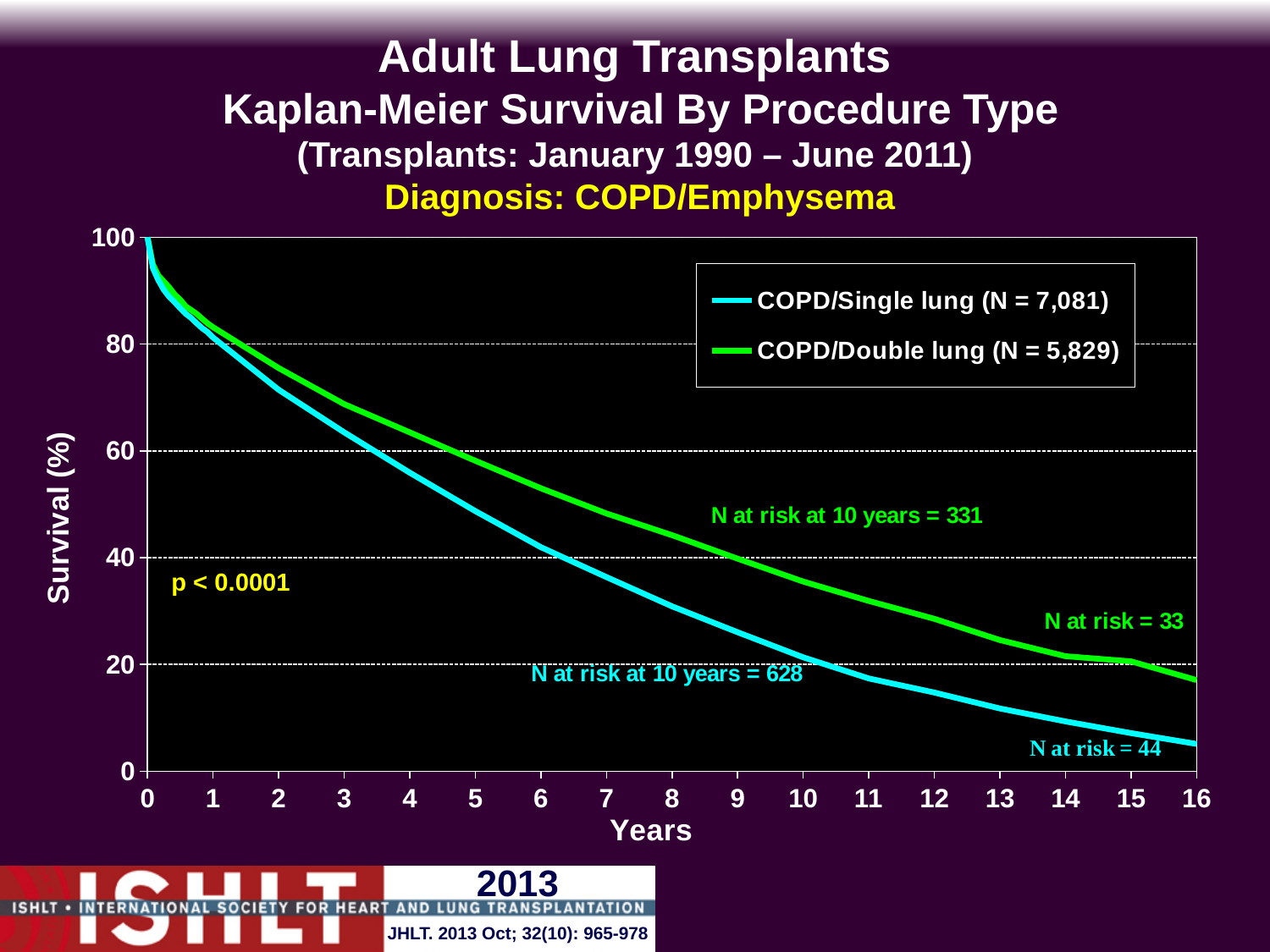
What is the N at risk at 10 years for the COPD/Single lung group? 628 What is the N for the COPD/Double lung group shown in the legend? 5,829 At 8 years, which curve shows higher survival, COPD/Single lung or COPD/Double lung? COPD/Double lung What is the N at risk at 10 years for the COPD/Double lung group? 331 Which group has the larger N in the legend, COPD/Single lung or COPD/Double lung? COPD/Single lung What kind of chart is shown on the slide? line chart What is the difference between the N at risk at 10 years for the single lung group and the double lung group? 297 What is the N for the COPD/Single lung group shown in the legend? 7,081 Is the survival for COPD/Single lung at 10 years greater or less than 40? less What p-value is printed on the chart? p < 0.0001 How many series does the legend list? 2 Do the survival curves rise or fall as years increase? fall